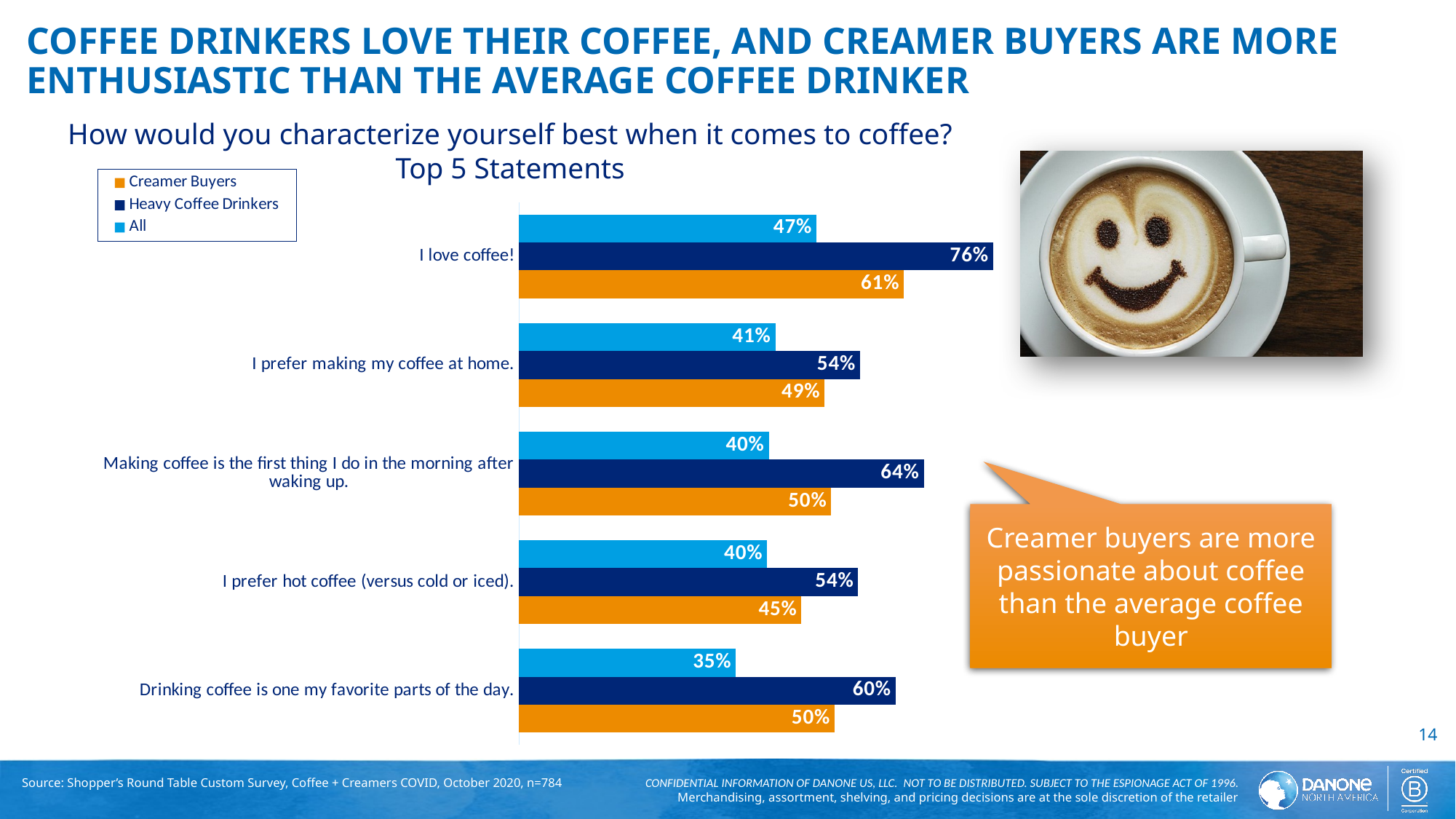
Which statement has the highest value for Heavy Coffee Drinkers? I love coffee! Which colour represents Creamer Buyers in the chart? Orange For "I prefer hot coffee (versus cold or iced).", which group has the larger value: Creamer Buyers or All? Creamer Buyers What is the value for All respondents on "Drinking coffee is one my favorite parts of the day."? 35% What is the difference between Heavy Coffee Drinkers and All respondents for "I love coffee!"? 29 percentage points What type of chart is shown on the slide? Bar chart What percentage of Creamer Buyers agree with "I prefer making my coffee at home."? 49% What percentage of Heavy Coffee Drinkers agree with the statement "I love coffee!"? 76% How many series does the legend list? 3 How many statements are shown in the chart? 5 What is the difference between Creamer Buyers and All respondents for "Making coffee is the first thing I do in the morning after waking up."? 10 percentage points Which statement has the lowest value for All respondents? Drinking coffee is one my favorite parts of the day.